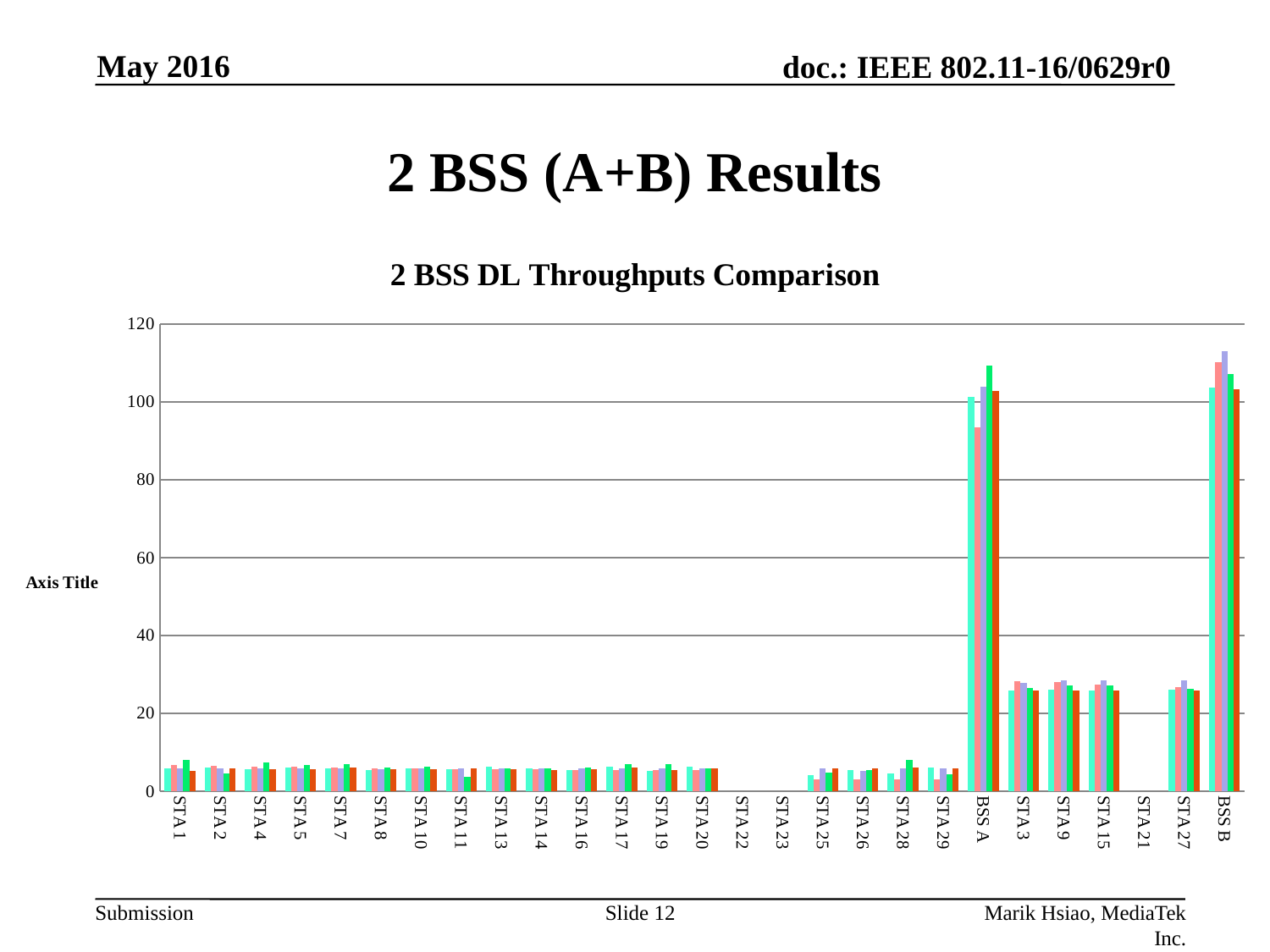
What kind of chart is shown on the slide? bar chart Which has the larger value, BSS A or STA 27? BSS A Is the value for STA 3 greater or less than 20? greater What is the title of the chart? 2 BSS DL Throughputs Comparison Is the value for BSS B greater or less than 100? greater What is the label shown on the vertical axis of the chart? Axis Title Is the value for BSS A greater or less than 80? greater How many categories are shown along the x axis of the chart? 27 Which has the larger value, BSS B or STA 3? BSS B Which has the larger value, STA 3 or STA 1? STA 3